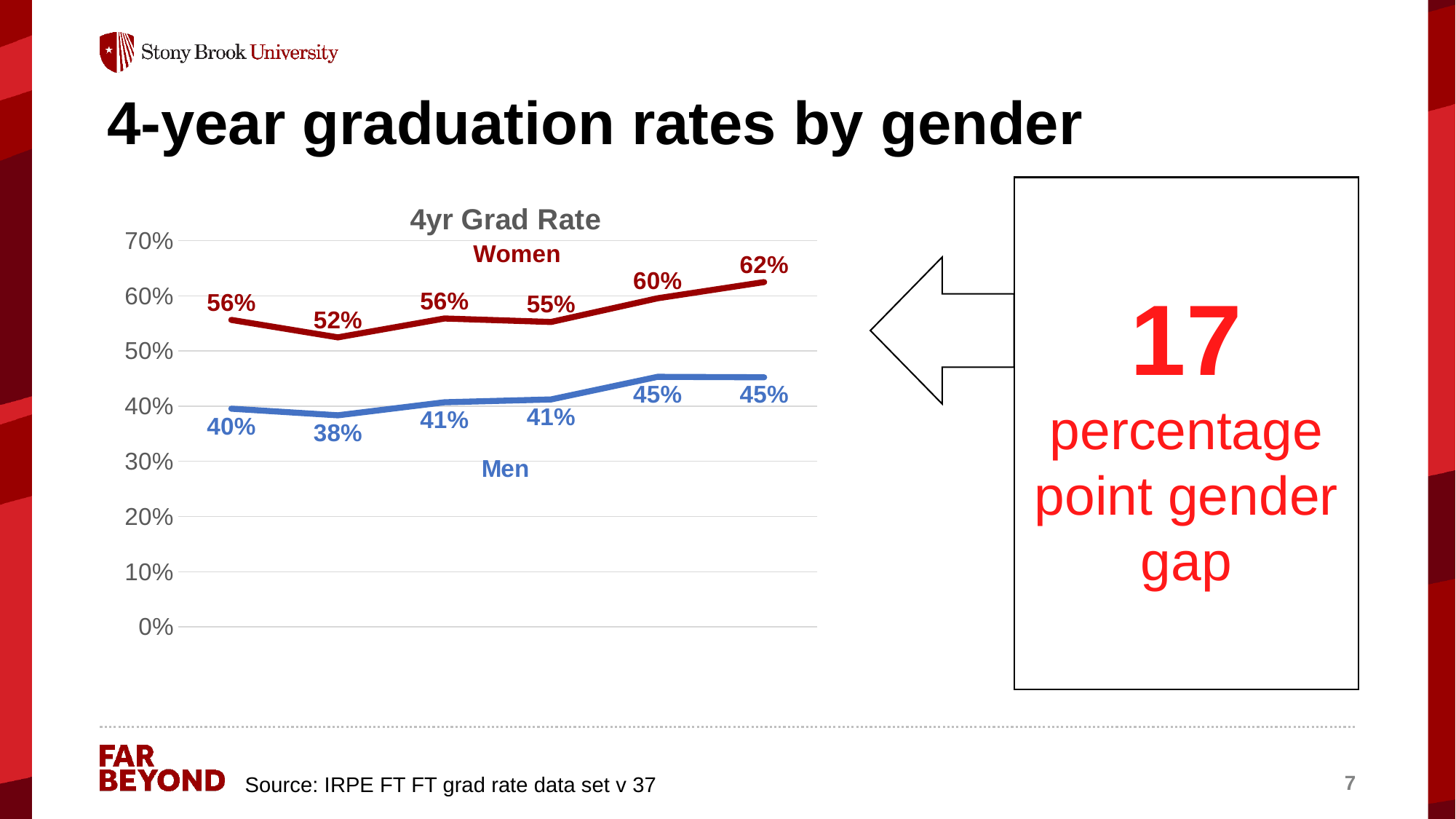
What kind of chart is shown on the slide? line chart What is the title of the chart? 4yr Grad Rate What is the value of the last (rightmost) point on the Women line? 62% Is the last (rightmost) value on the Men line greater or less than 50%? less What is the highest value on the Women line? 62% At the first (leftmost) point, which series has the higher value, Women or Men? Women What is the lowest value on the Men line? 38% What is the difference between the Women and Men values at the last (rightmost) point? 17 percentage points How many series are plotted in the chart? 2 How many data points does the Women line have? 6 What is the lowest value on the Women line? 52% What is the value of the first (leftmost) point on the Men line? 40%